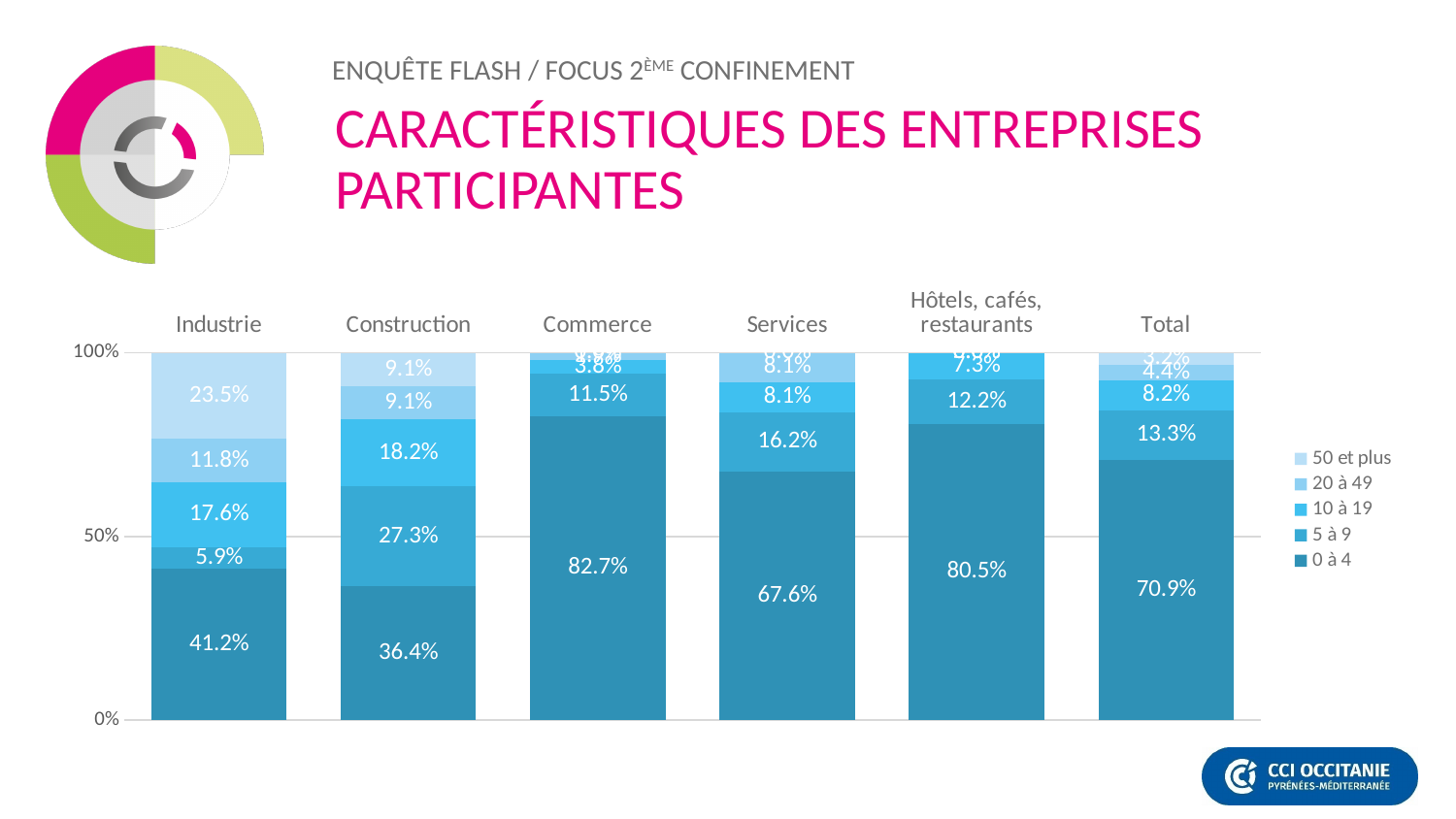
Which series is shown in the darkest blue at the bottom of each bar? 0 à 4 What kind of chart is shown on the slide? stacked bar chart What is the value of the "0 à 4" segment for Industrie? 41.2% Which category has the lowest value for the "0 à 4" series? Construction How many series does the legend list? 5 What is the value of the "50 et plus" segment for Industrie? 23.5% Which category has the highest value for the "0 à 4" series? Commerce What is the value of the "5 à 9" segment for Construction? 27.3% How many categories are shown along the x axis? 6 Which is larger: the "5 à 9" value for Services or for Hôtels, cafés, restaurants? Services What is the value of the "0 à 4" segment for Total? 70.9% What is the difference between the "0 à 4" values for Commerce and Services? 15.1%